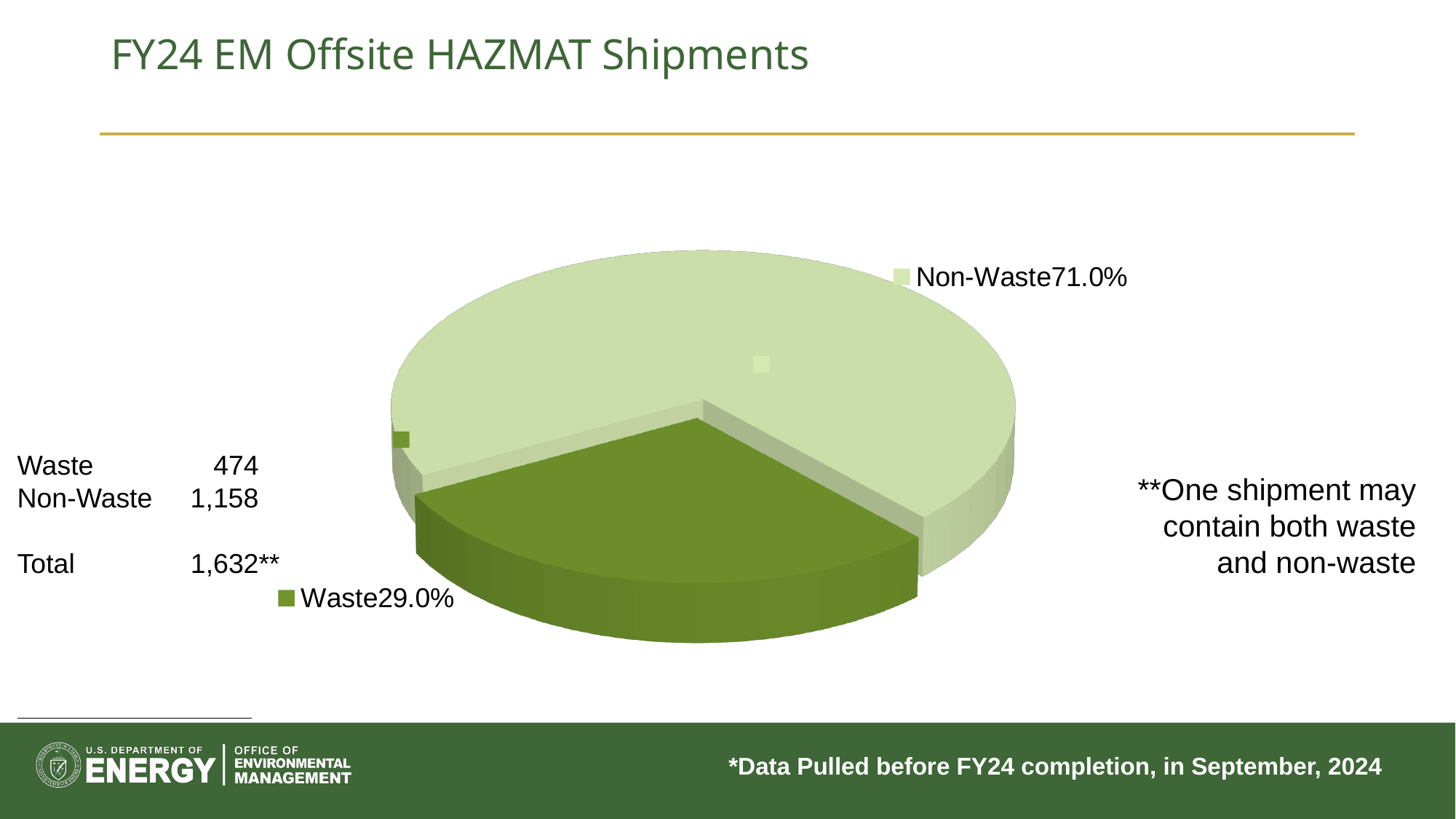
What is the title of the slide containing the pie chart? FY24 EM Offsite HAZMAT Shipments What share of the pie does the Waste slice represent? 29.0% Which slice of the pie is the largest? Non-Waste What share of the pie does the Non-Waste slice represent? 71.0% How many slices does the pie chart have? 2 How many Waste shipments are listed in the table next to the chart? 474 How many Non-Waste shipments are listed in the table next to the chart? 1,158 What is the difference in percentage points between the Non-Waste and Waste slices? 42.0% Which slice of the pie is the smallest? Waste Which is larger, the Waste slice or the Non-Waste slice? Non-Waste What kind of chart is shown on the slide? Pie chart What is the total number of shipments listed on the slide? 1,632